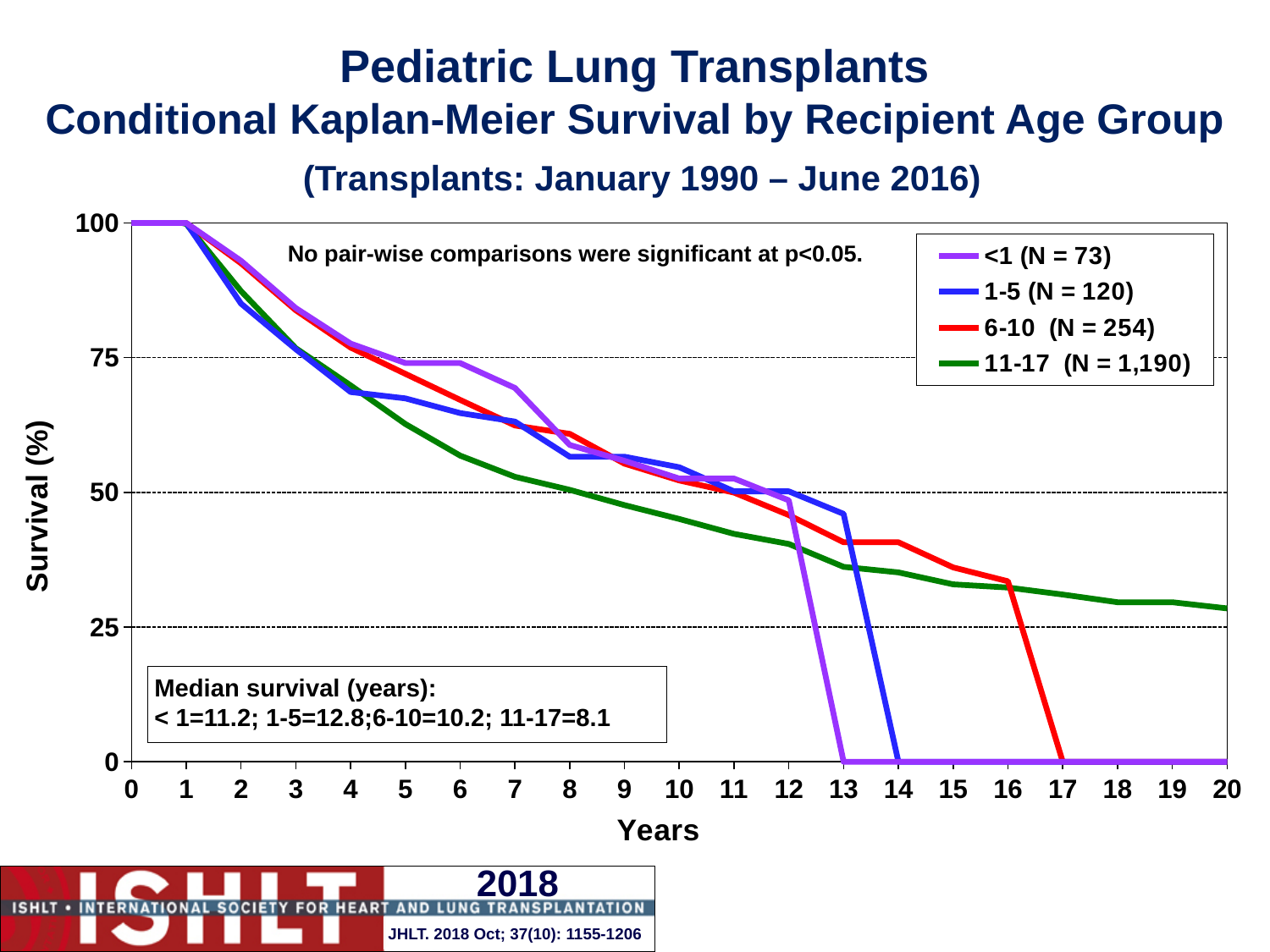
What kind of chart is shown on the slide? line chart What is the difference in median survival (years) between the 1-5 group and the 6-10 group? 2.6 Which recipient age group has the largest N in the legend? 11-17 Which recipient age group has the smallest N in the legend? <1 What is the median survival in years for the 1-5 age group? 12.8 What is the median survival in years for the 11-17 age group? 8.1 Which group has a longer median survival, <1 or 11-17? <1 How many series does the legend list? 4 What is the N for the 6-10 age group? 254 Is the survival value for the 11-17 group at year 10 greater or less than 50? less Is the survival value for the 11-17 group at year 18 greater or less than 25? greater Do the survival curves rise or fall as years increase? fall